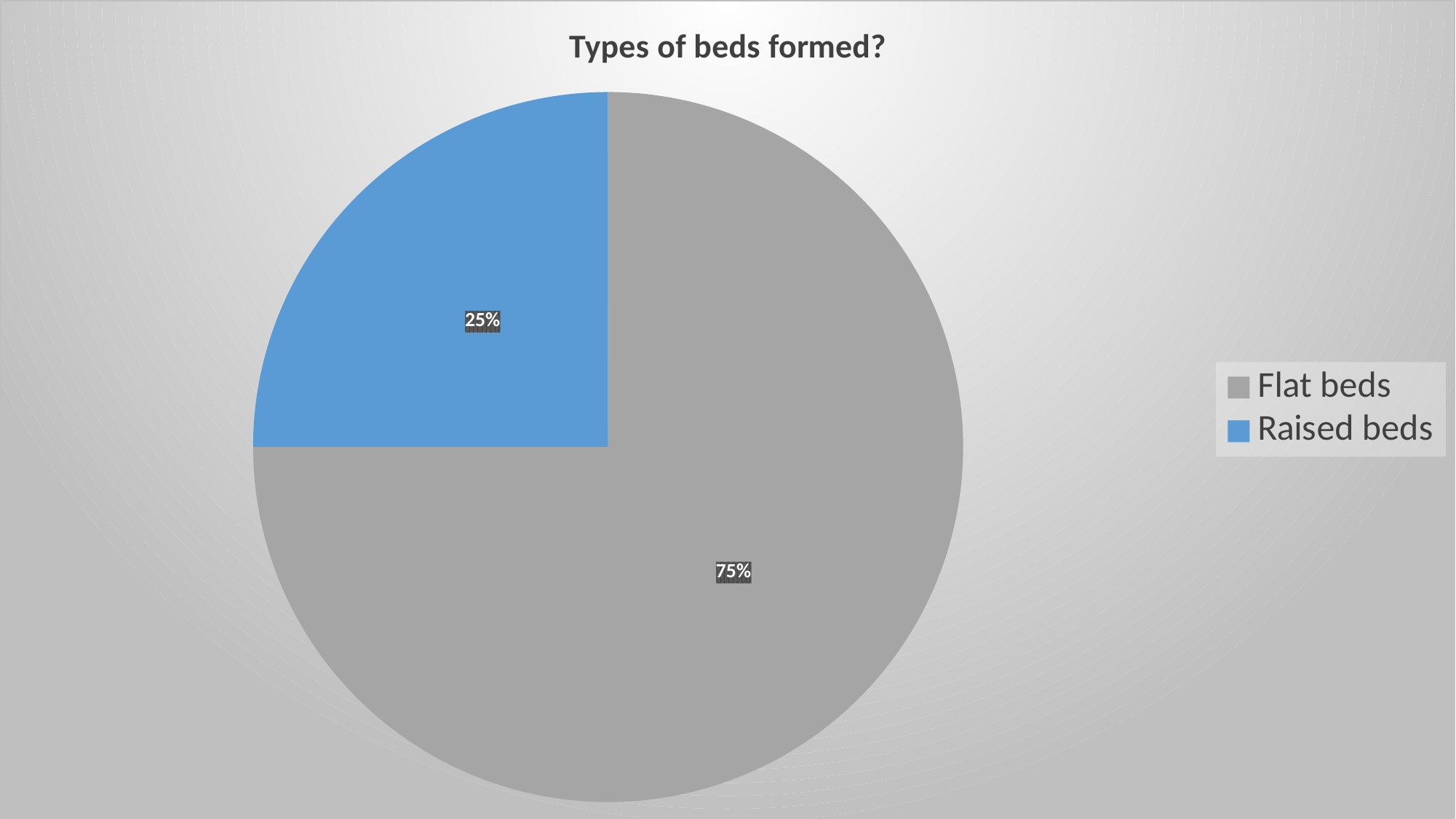
What share of the pie is Flat beds? 75% What is the difference in percentage points between Flat beds and Raised beds? 50 Which category has the smallest slice of the pie? Raised beds What is the total of the two slices shown? 100% Which is larger, the share for Flat beds or the share for Raised beds? Flat beds What colour is the Raised beds slice? Blue Which category has the largest slice of the pie? Flat beds How many categories does the pie chart show? 2 What is the title of the chart? Types of beds formed? What share of the pie is Raised beds? 25% What kind of chart is shown on the slide? Pie chart